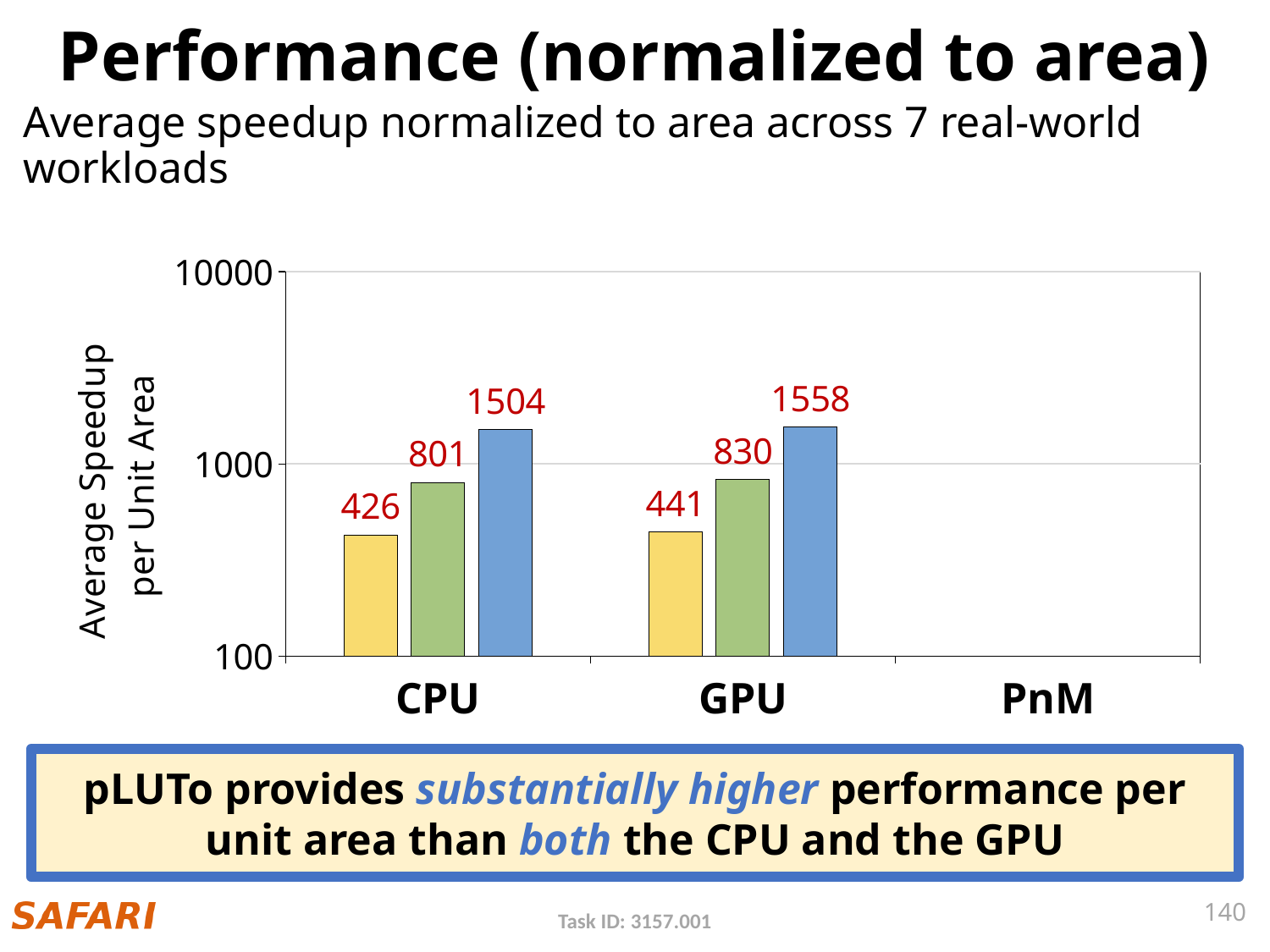
What is the difference between the green bar and the yellow bar for CPU? 375 Which is larger, the green bar for GPU or the green bar for CPU? The green bar for GPU (830) Which bar has the lowest value on the chart? The yellow bar for CPU (426) Which bar has the highest value on the chart? The blue bar for GPU (1558) What is the label of the y axis? Average Speedup per Unit Area How many categories are shown on the x axis? 3 What is the value of the yellow bar for CPU? 426 What is the value of the yellow bar for GPU? 441 What is the difference between the blue bar for GPU and the blue bar for CPU? 54 What type of chart is shown on the slide? Bar chart What is the value of the blue bar for GPU? 1558 What is the value of the green bar for CPU? 801